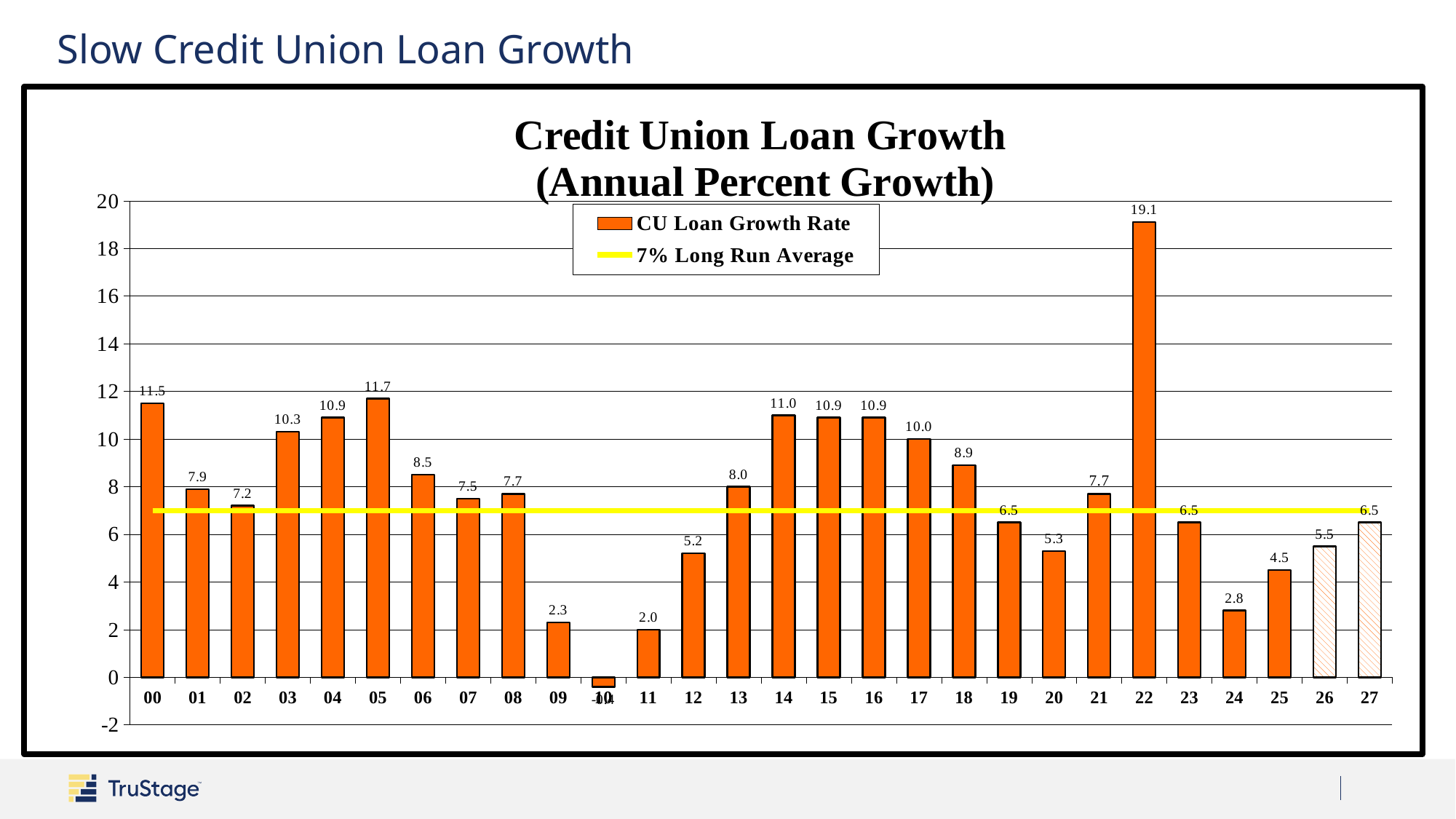
What is the difference between the CU Loan Growth Rate for 22 and for 23? 12.6 Is the CU Loan Growth Rate for 09 greater or less than 4? less How many years are shown on the x axis? 28 How many entries does the legend list? 2 Which year has the lowest CU Loan Growth Rate? 10 What is the CU Loan Growth Rate for 24? 2.8 Which is larger, the CU Loan Growth Rate for 00 or for 14? 00 Which year has the highest CU Loan Growth Rate? 22 What kind of chart is shown? bar chart What is the CU Loan Growth Rate for 05? 11.7 What is the CU Loan Growth Rate for 22? 19.1 What is the CU Loan Growth Rate for 26? 5.5